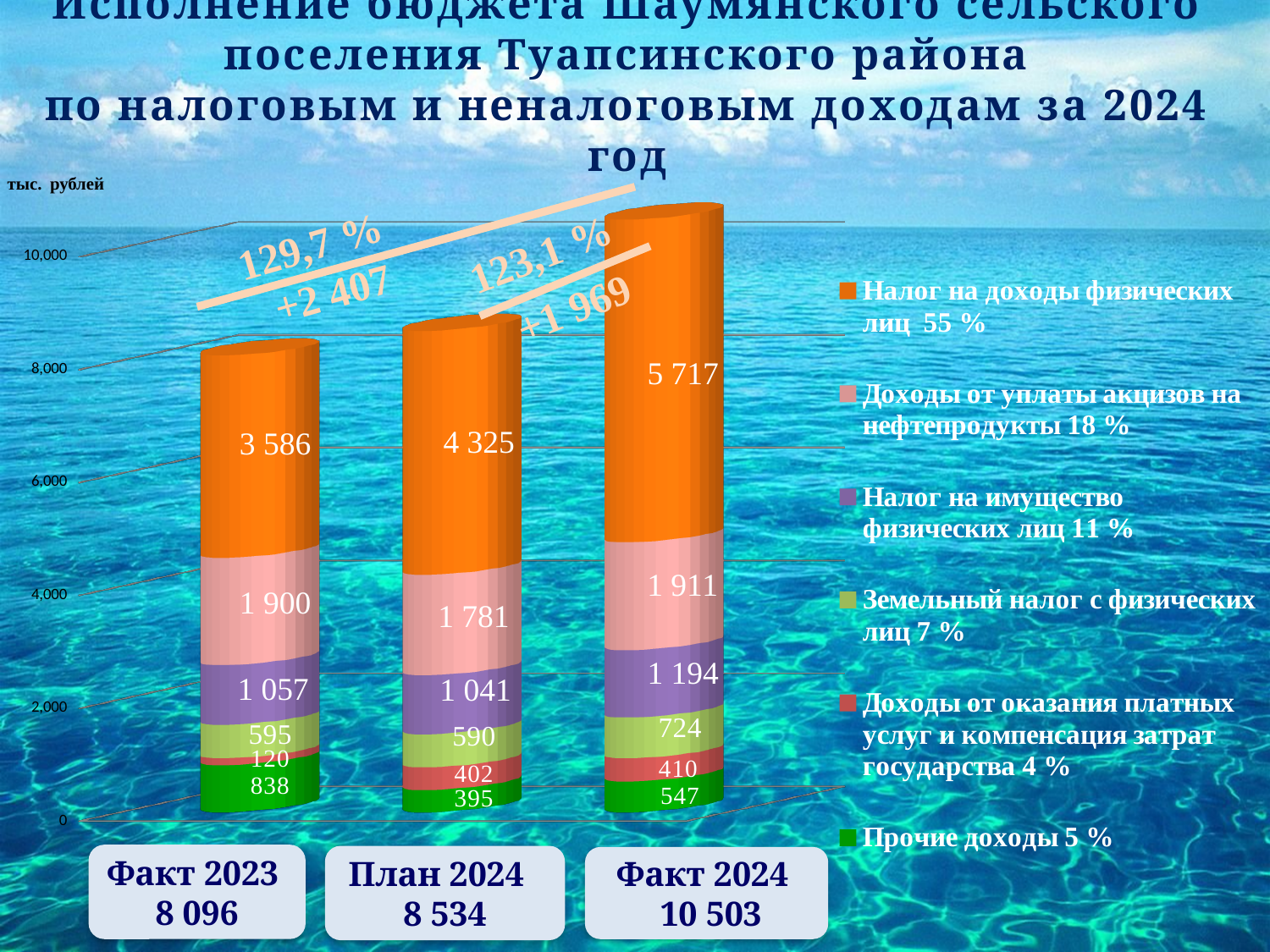
What is the value of Доходы от уплаты акцизов на нефтепродукты for План 2024? 1 781 How many series does the legend list? 6 Do the bar totals rise or fall from Факт 2023 to Факт 2024? Rise How many categories (bars) are shown in the chart? 3 What is the difference in Налог на доходы физических лиц between Факт 2024 and Факт 2023? 2 131 What kind of chart is shown on the slide? Stacked bar chart What is the value of Доходы от оказания платных услуг и компенсация затрат государства for Факт 2023? 120 Which category has the highest total? Факт 2024 What is the total of the stacked bar for Факт 2023? 8 096 What is the value of Прочие доходы for Факт 2023? 838 What is the value of Налог на доходы физических лиц for Факт 2024? 5 717 Which is larger for Земельный налог с физических лиц: План 2024 or Факт 2024? Факт 2024